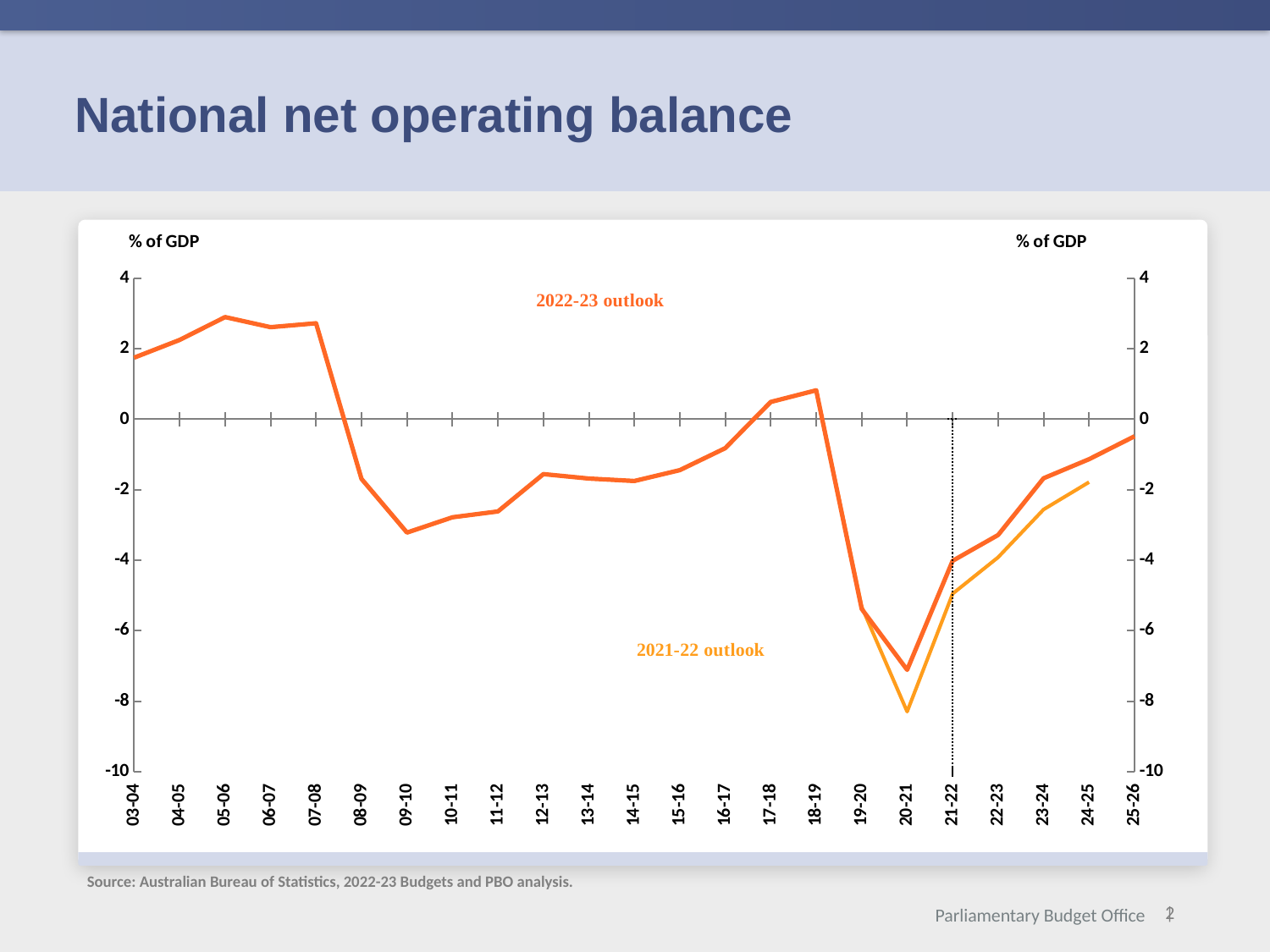
What is the title of the slide's chart? National net operating balance What kind of chart is shown on the slide? line chart How many financial years are labelled along the x axis? 23 Is the value of the 2021-22 outlook in 20-21 greater or less than -8? less Does the 2022-23 outlook line rise or fall from 21-22 to 25-26? rise Is the value of the 2022-23 outlook in 20-21 greater or less than -6? less Is the value of the 2022-23 outlook in 09-10 greater or less than -2? less In which year does the 2022-23 outlook line reach its lowest value? 20-21 In 24-25, which series shows the higher value: the 2022-23 outlook or the 2021-22 outlook? 2022-23 outlook How many outlook series are plotted on the chart? 2 What unit is shown on the vertical axis? % of GDP